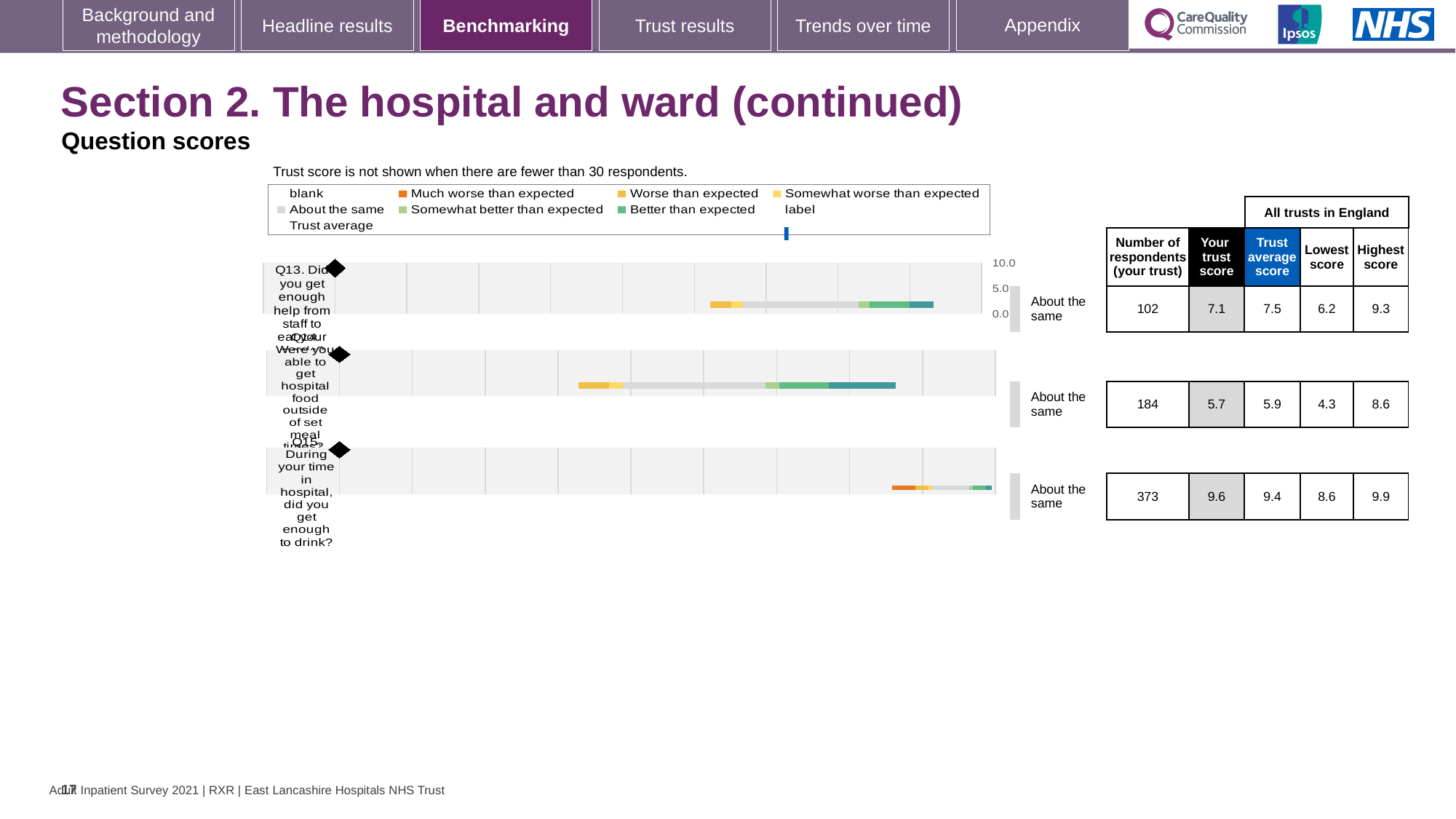
What is the 'Your trust score' for Q13 (Did you get enough help from staff to eat your meals?)? 7.1 How many questions are plotted on the slide? 3 What is the lowest score across all trusts in England for Q14? 4.3 What is the highest score across all trusts in England for Q15 (did you get enough to drink?)? 9.9 What benchmark category is shown next to the Q14 chart? About the same Which question has the lowest trust average score? Q14 Which question has the highest 'Your trust score'? Q15 How many respondents (your trust) are shown for Q14 (Were you able to get hospital food outside of set meal times?)? 184 For Q15, which is larger: your trust score or the trust average score? Your trust score For Q13, what is the difference between the trust average score and your trust score? 0.4 What kind of chart is used to show the question scores? Bar chart For Q15, what is the difference between the highest score and the lowest score? 1.3